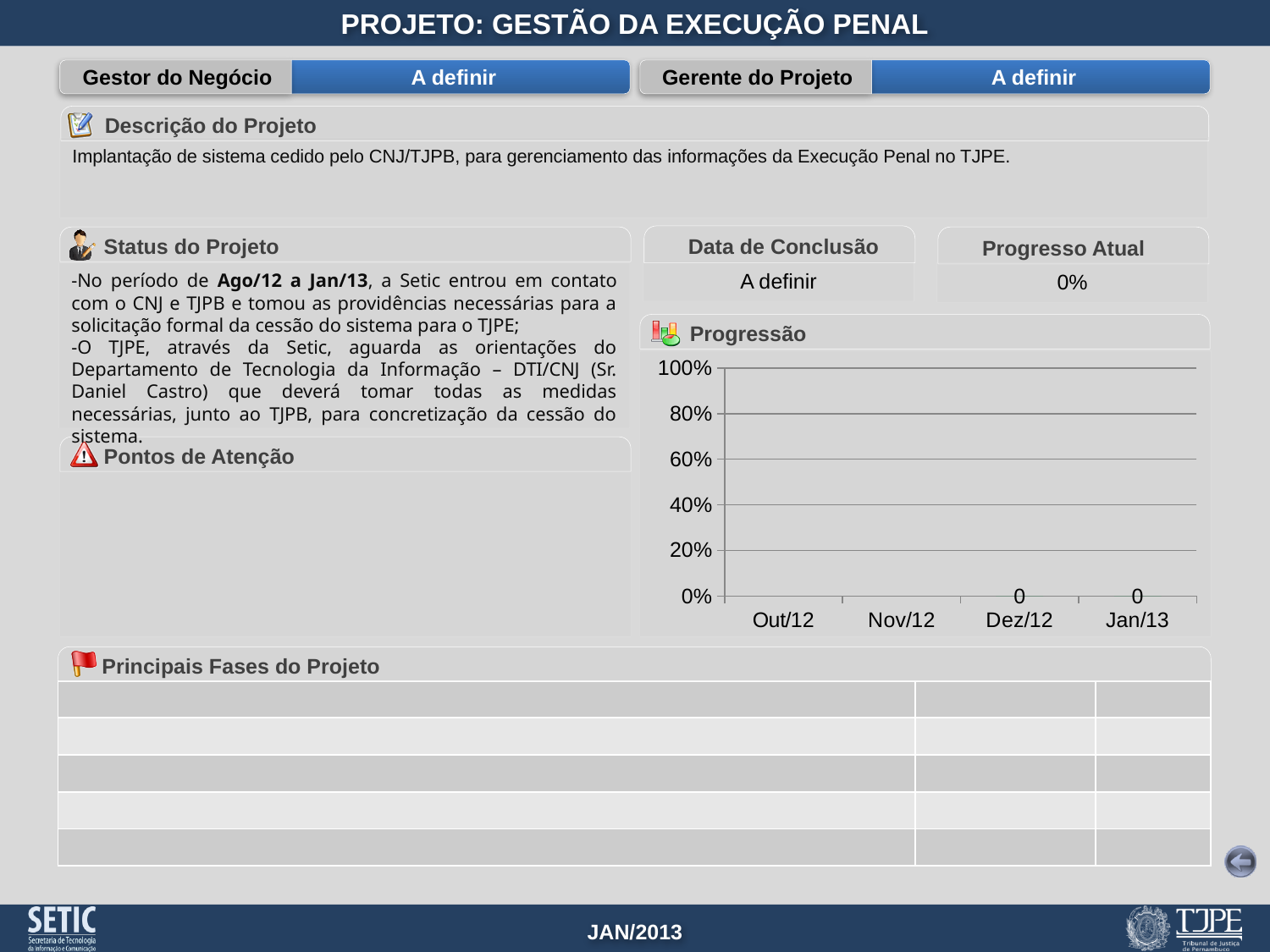
How many categories are shown on the x axis of the Progressão chart? 4 What is the highest value shown on the y axis of the Progressão chart? 100% Is the value for Dez/12 in the Progressão chart greater or less than 20%? less What value is labelled for Dez/12 in the Progressão chart? 0 What value is labelled for Jan/13 in the Progressão chart? 0 Is the value for Jan/13 in the Progressão chart greater or less than 20%? less What is the difference between the labelled values for Dez/12 and Jan/13 in the Progressão chart? 0 What is the title of the chart on the slide? Progressão What is the first category on the x axis of the Progressão chart? Out/12